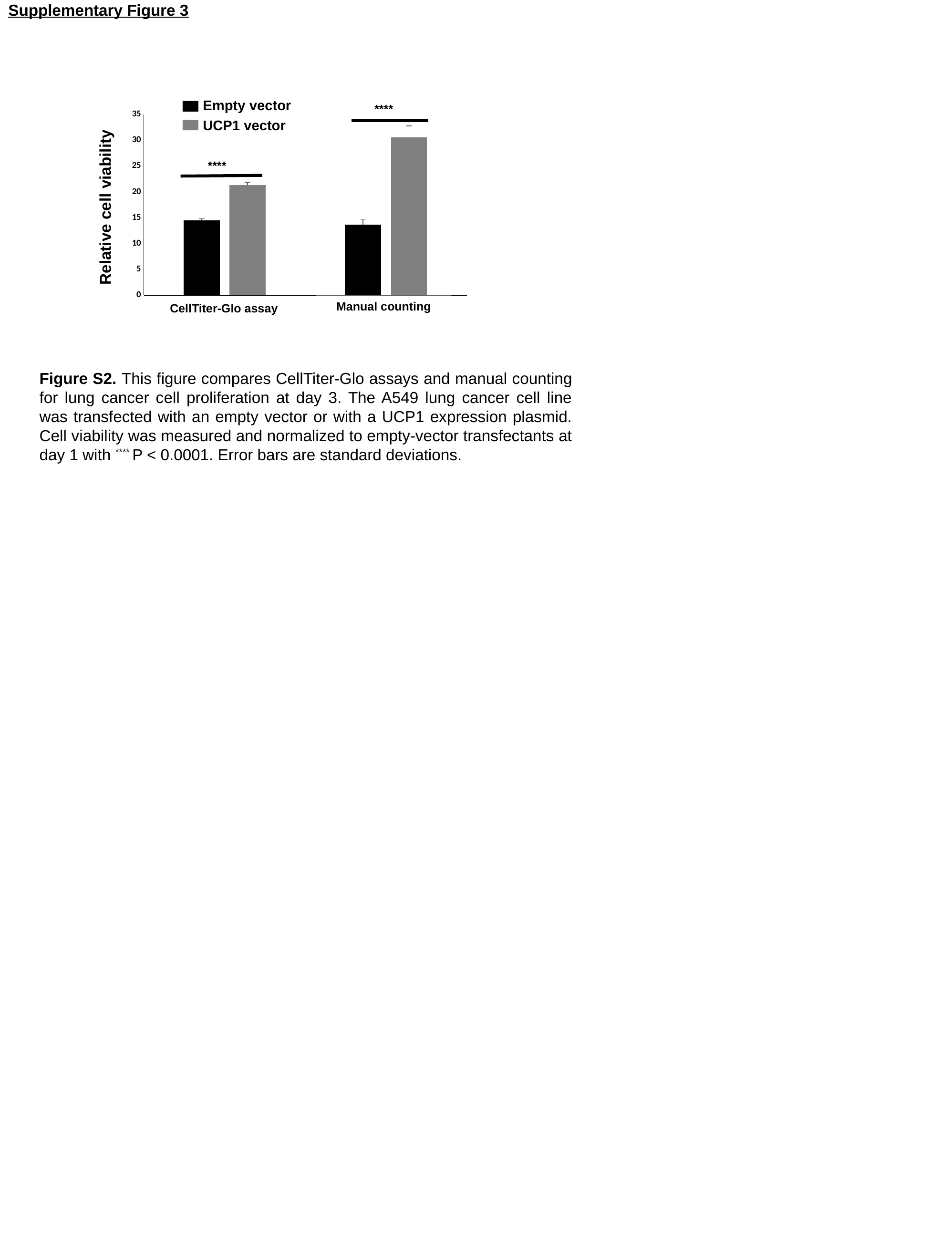
Which bar is the highest in the chart? UCP1 vector, Manual counting What is the label of the y axis? Relative cell viability Is the value for UCP1 vector in the CellTiter-Glo assay greater or less than 15? greater Is the value for Empty vector in Manual counting greater or less than 20? less Is the value for Empty vector in the CellTiter-Glo assay greater or less than 20? less How many categories are shown on the x axis? 2 What kind of chart is shown on the slide? bar chart For Manual counting, which is larger: Empty vector or UCP1 vector? UCP1 vector How many series does the legend list? 2 What colour represents the Empty vector series in the legend? black For the CellTiter-Glo assay, which is larger: Empty vector or UCP1 vector? UCP1 vector